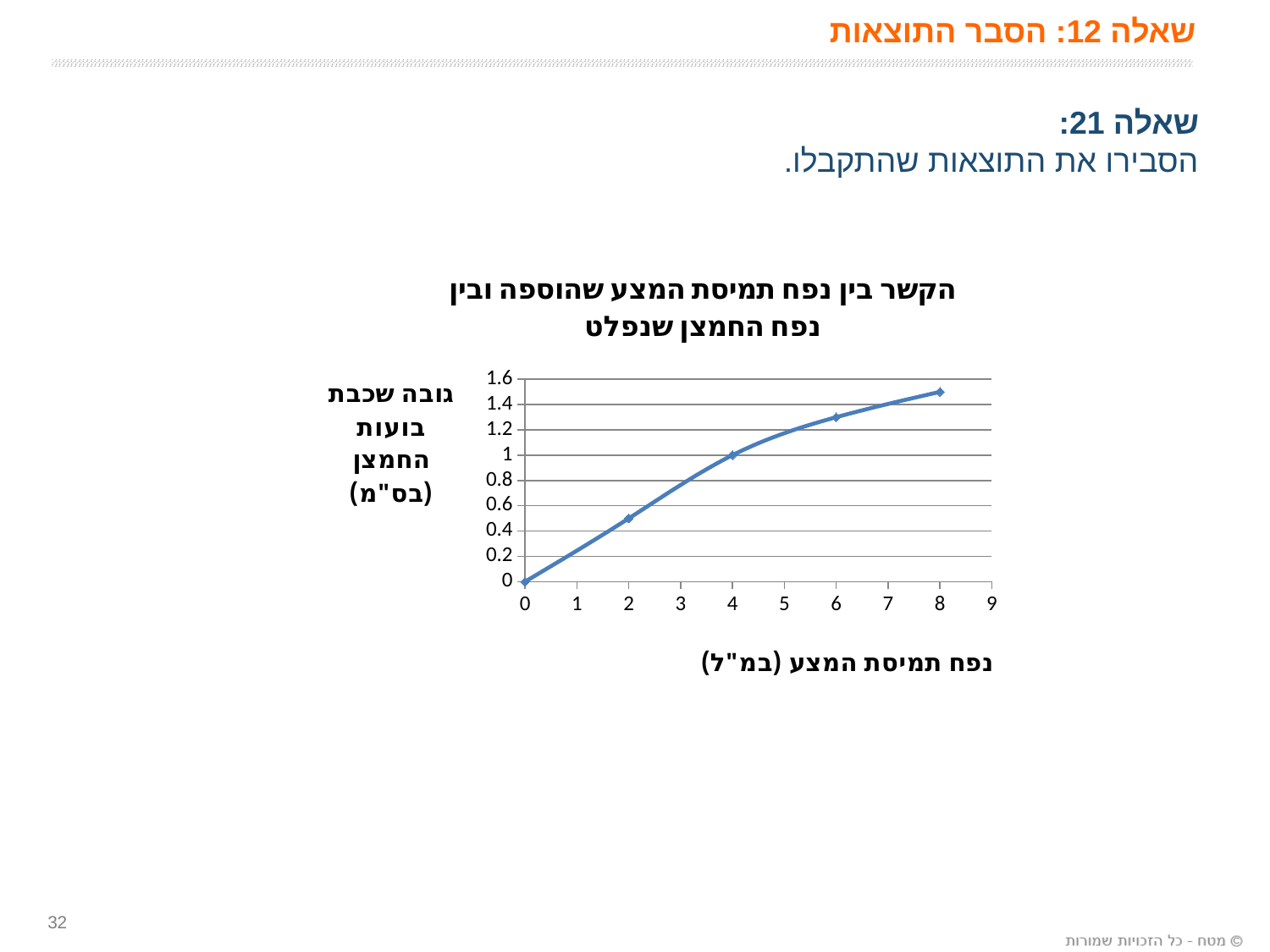
Is the value at x = 8 greater or less than 1.6? less What is the label of the x axis? נפח תמיסת המצע (במ"ל) At which x value is the plotted value lowest? 0 What is the y value at x = 0? 0 How many data points are plotted on the line? 5 What kind of chart is shown on the slide? line chart Which is larger, the value at x = 6 or the value at x = 2? x = 6 Is the value at x = 2 greater or less than 0.4? greater Is the value at x = 6 greater or less than 1.2? greater What is the y value at x = 4? 1 Do the values rise or fall as x increases? rise At which x value is the plotted value highest? 8